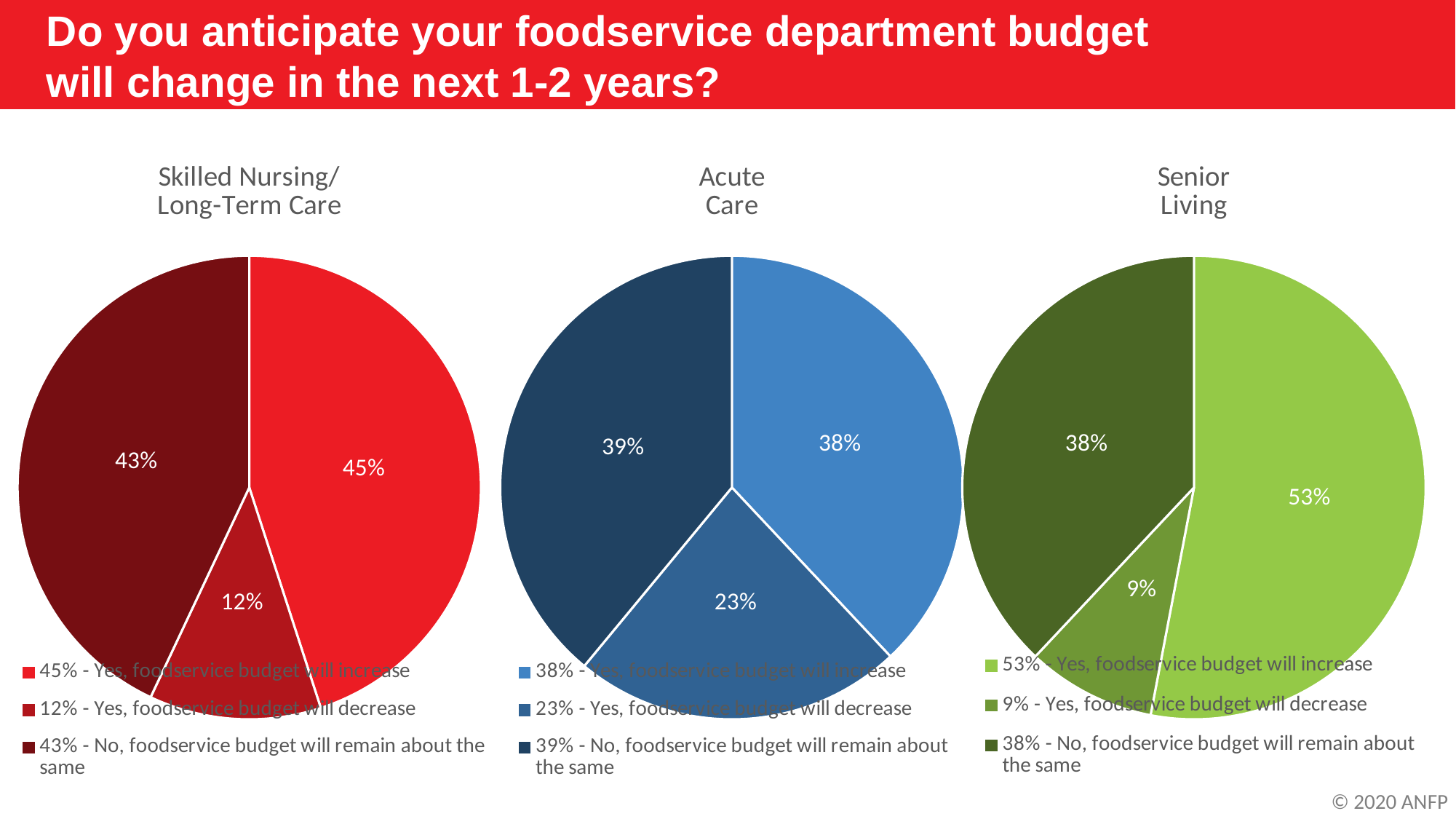
In the Senior Living pie chart, what is the difference in percentage points between the 'will increase' slice and the 'will decrease' slice? 44 In the Skilled Nursing/Long-Term Care pie chart, what share of respondents said the foodservice budget will increase? 45% How many pie charts are shown on the slide? 3 What type of chart is used for the Skilled Nursing/Long-Term Care data? Pie chart In the Acute Care pie chart, what is the difference in percentage points between the 'will remain about the same' slice and the 'will decrease' slice? 16 In the Acute Care pie chart, what share of respondents said the foodservice budget will decrease? 23% In the Skilled Nursing/Long-Term Care pie chart, which response has the smallest slice? Yes, foodservice budget will decrease Which is larger: the 'will increase' share in the Senior Living chart or the 'will increase' share in the Acute Care chart? Senior Living In the Acute Care pie chart, which response has the smallest slice? Yes, foodservice budget will decrease In the Senior Living pie chart, what share of respondents said the foodservice budget will remain about the same? 38% In the Senior Living pie chart, which response has the largest slice? Yes, foodservice budget will increase How many slices does the Acute Care pie chart have? 3